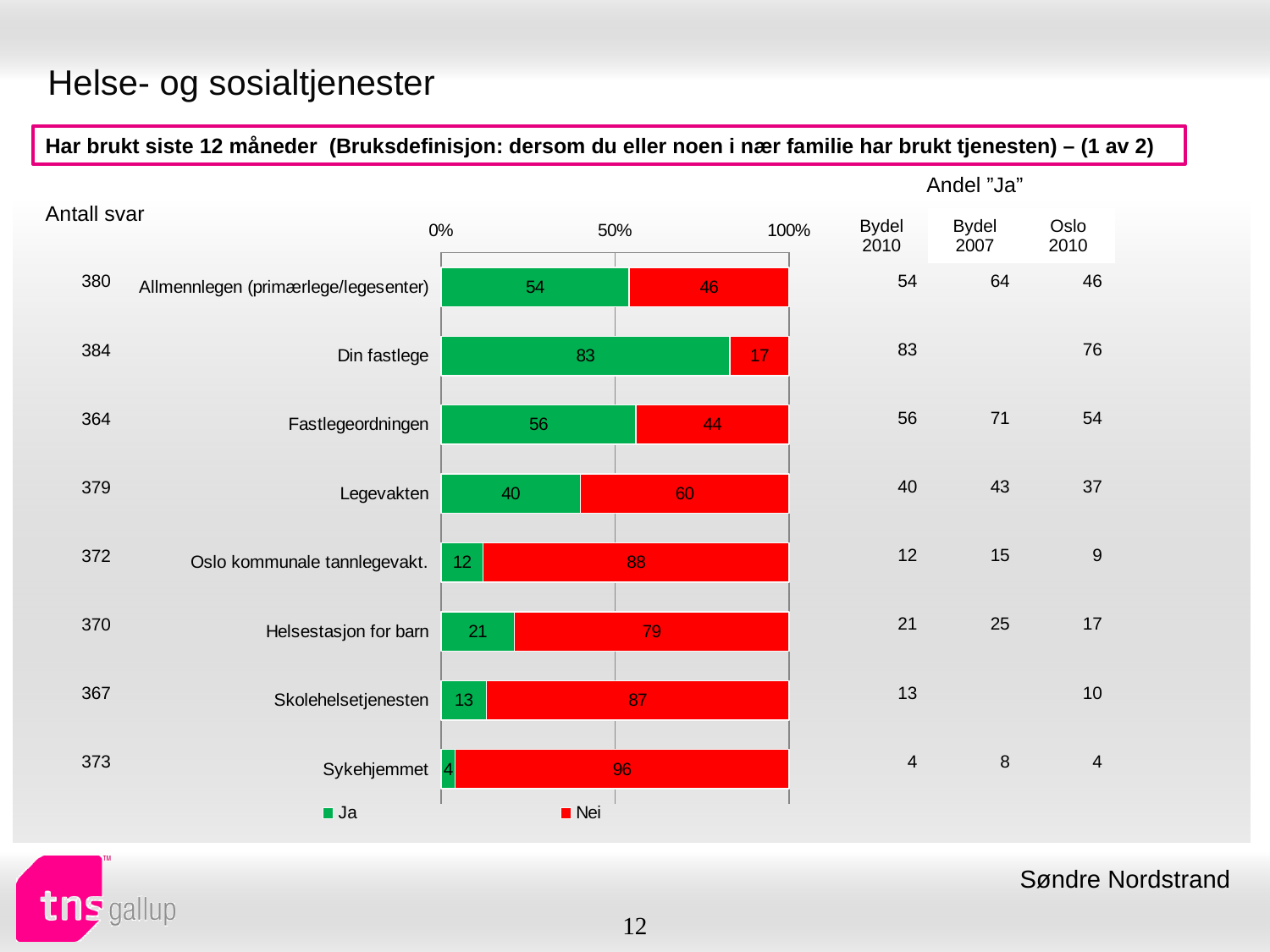
How many categories are shown in the chart? 8 What is the difference between the "Ja" values for Fastlegeordningen and Legevakten? 16 What is the total of the stacked bar for Allmennlegen (primærlege/legesenter)? 100 Which category has the lowest "Ja" value? Sykehjemmet What colour represents the "Nei" series? Red Which category has the highest "Ja" value? Din fastlege What is the "Ja" value for Din fastlege? 83 Which has a larger "Nei" value, Helsestasjon for barn or Skolehelsetjenesten? Skolehelsetjenesten What is the "Nei" value for Legevakten? 60 How many series does the legend list? 2 What kind of chart is shown? Stacked bar chart What is the "Ja" value for Oslo kommunale tannlegevakt.? 12